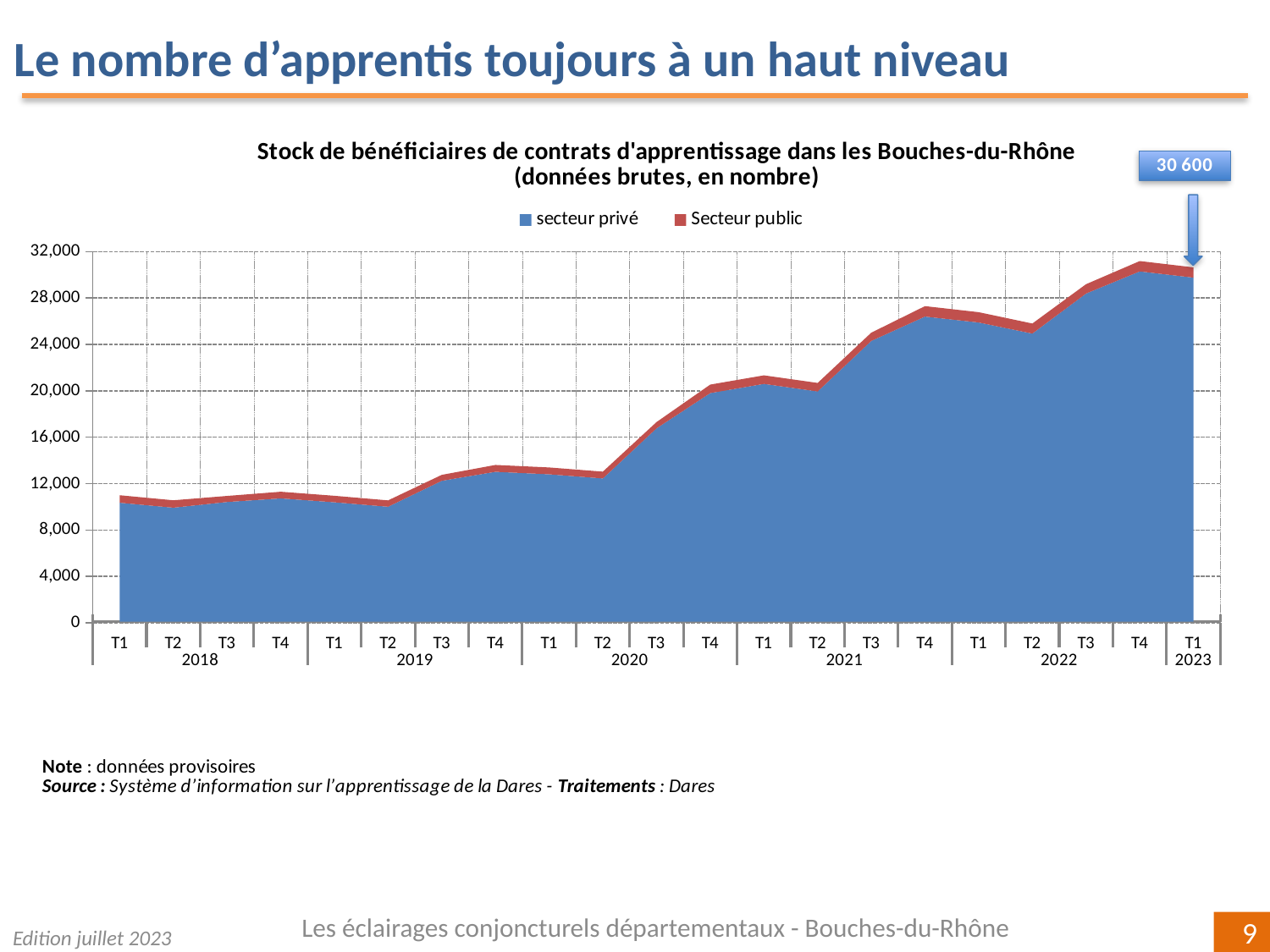
What type of chart is shown on the slide? area chart Is the total value for T4 2021 greater or less than 24,000? greater Is the total value for T2 2020 greater or less than 16,000? less What are the two series named in the legend? secteur privé and Secteur public What is the total stock of apprenticeship contract beneficiaries shown for T1 2023? 30 600 Which series accounts for the larger share of the stock, secteur privé or Secteur public? secteur privé How many series does the legend list? 2 Which is larger, the total value for T4 2021 or for T2 2022? T4 2021 Is the total value for T1 2018 greater or less than 12,000? less Overall, do the values rise or fall from T1 2018 to T1 2023? rise How many quarters are plotted along the x axis? 21